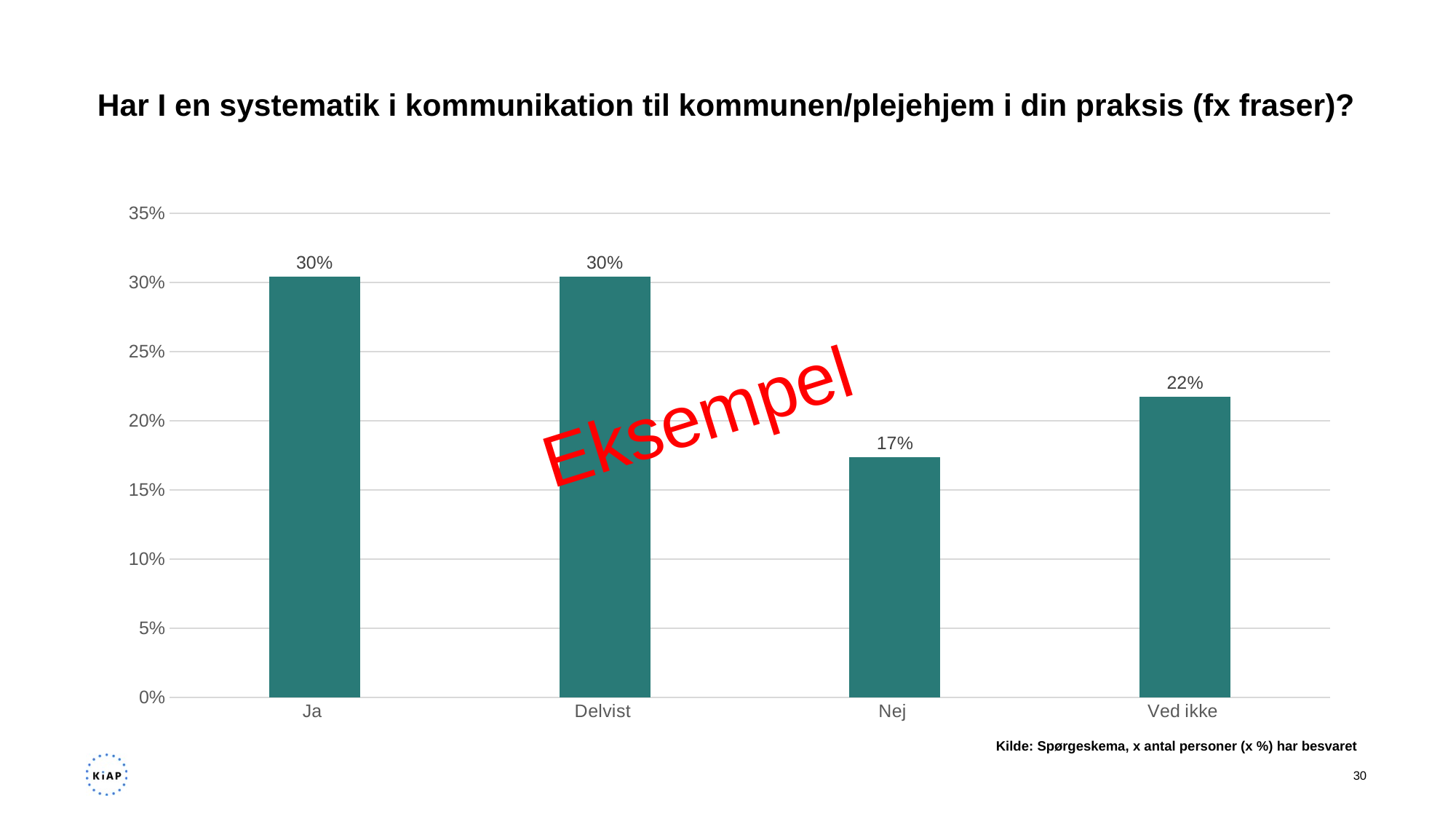
What is the value for Ved ikke? 22% What kind of chart is shown on the slide? bar chart Which category has the lowest value? Nej What is the value for Nej? 17% Which is larger, the value for Ved ikke or the value for Nej? Ved ikke What is the difference between the values for Ja and Ved ikke? 8% What red word is overlaid across the chart? Eksempel How many categories are shown on the x axis? 4 What is the value for Ja? 30% What is the difference between the values for Ved ikke and Nej? 5% Is the value for Nej greater or less than 20%? less What is the value for Delvist? 30%